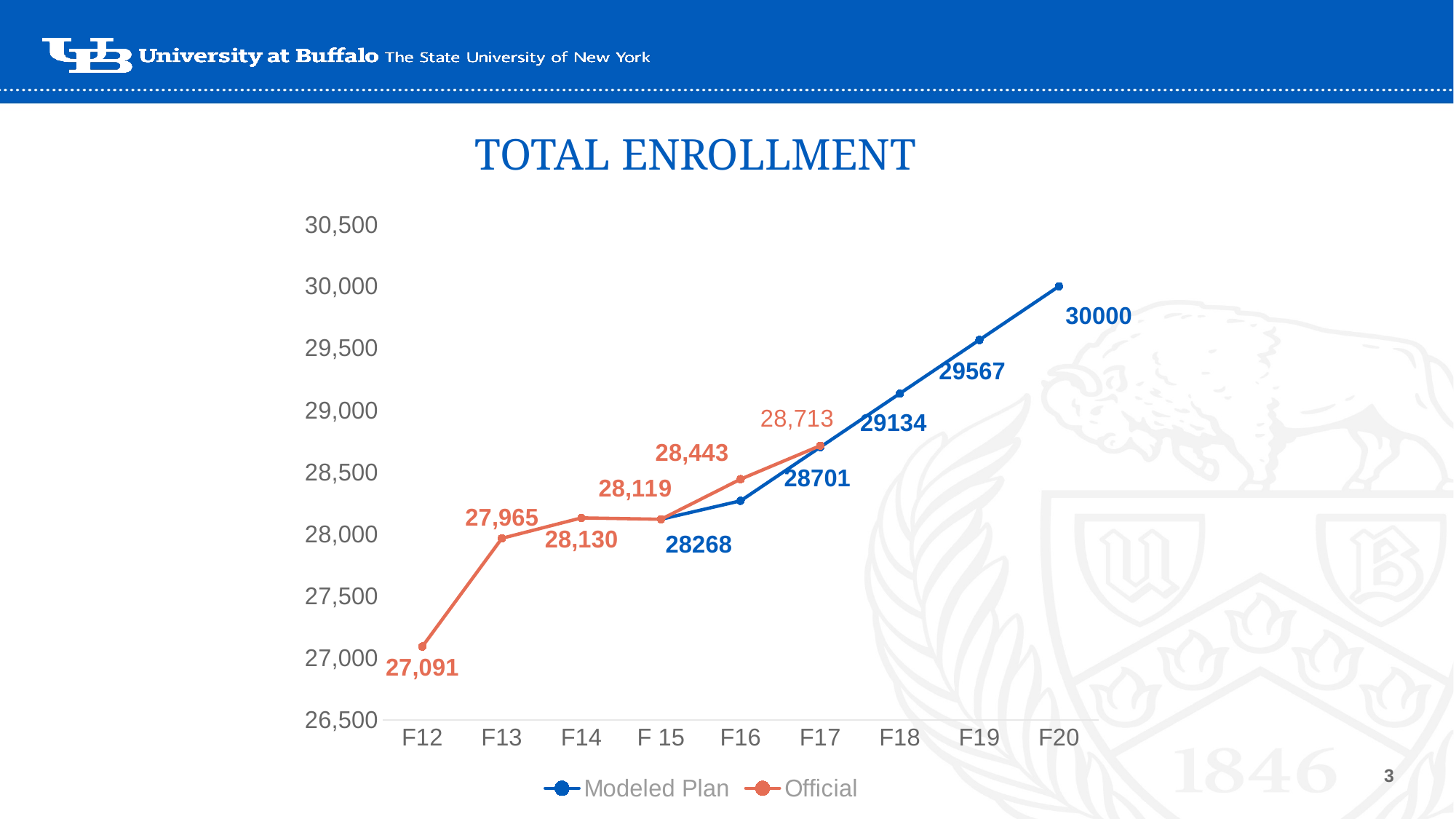
For F16, which series has the larger value, Official or Modeled Plan? Official What is the difference between the Modeled Plan values for F20 and F19? 433 In which year is the Official series at its lowest value? F12 In which year does the Modeled Plan series reach its highest value? F20 What is the Official enrollment value for F12? 27,091 What is the Official enrollment value for F17? 28,713 What is the Modeled Plan value for F18? 29134 By how much did the Official enrollment increase from F12 to F13? 874 What is the Modeled Plan value for F20? 30000 What kind of chart is shown on the slide? line chart How many years are shown on the x axis? 9 How many series does the legend list? 2